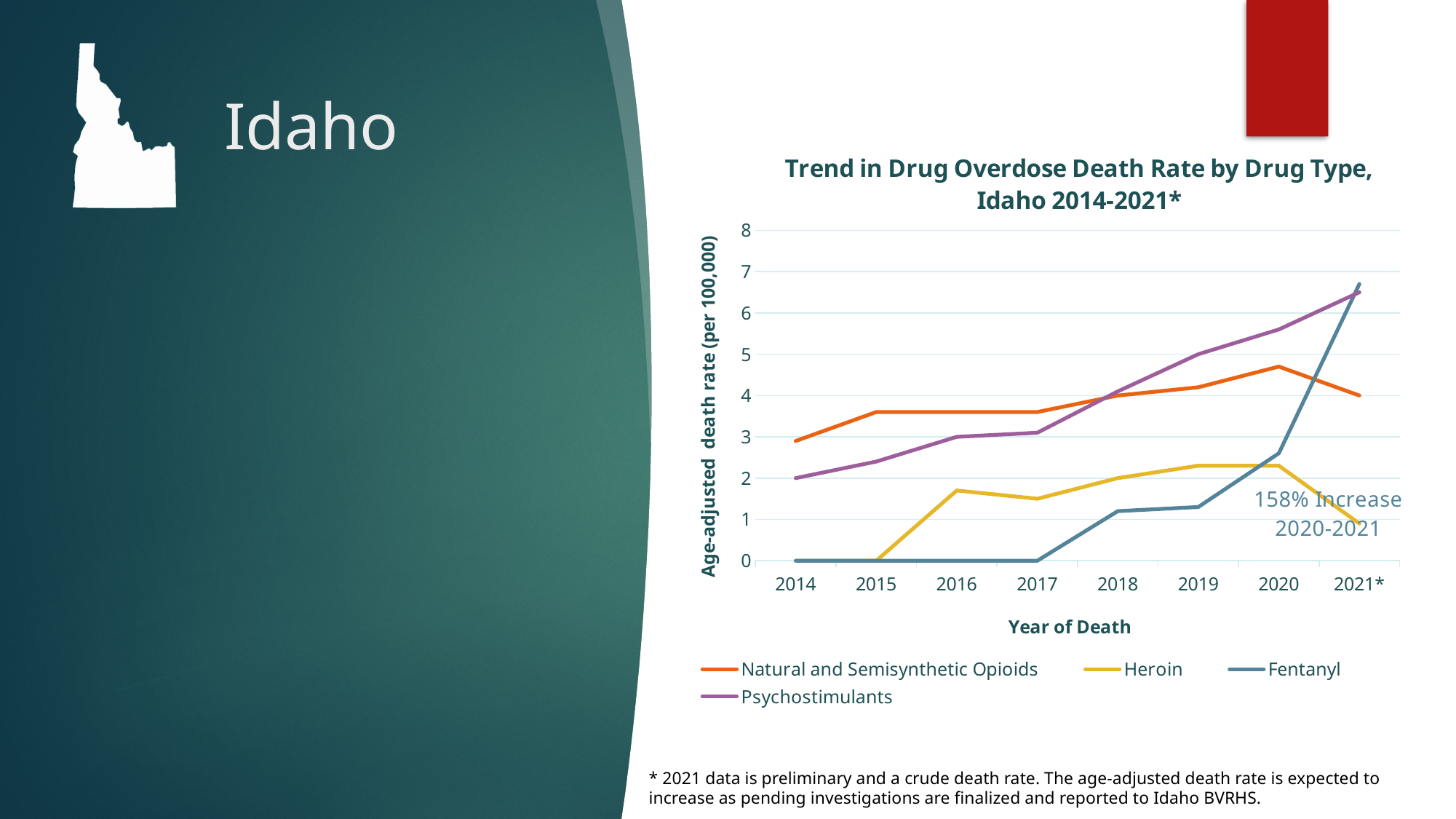
What percentage increase does the annotation on the chart state for 2020-2021? 158% Increase Which drug type has the lowest death rate in 2016? Fentanyl How many series does the legend list? 4 In 2018, which is higher: Natural and Semisynthetic Opioids or Heroin? Natural and Semisynthetic Opioids Is the Psychostimulants value for 2019 greater or less than 4? greater Which drug type has the highest death rate in 2020? Psychostimulants How many years are shown on the x axis? 8 What is the Fentanyl death rate in 2014? 0 Does the Psychostimulants line rise or fall from 2014 to 2021*? rise What kind of chart is shown on the slide? line chart Is the Fentanyl value for 2020 greater or less than 2? greater Is the Heroin value for 2021* greater or less than 2? less